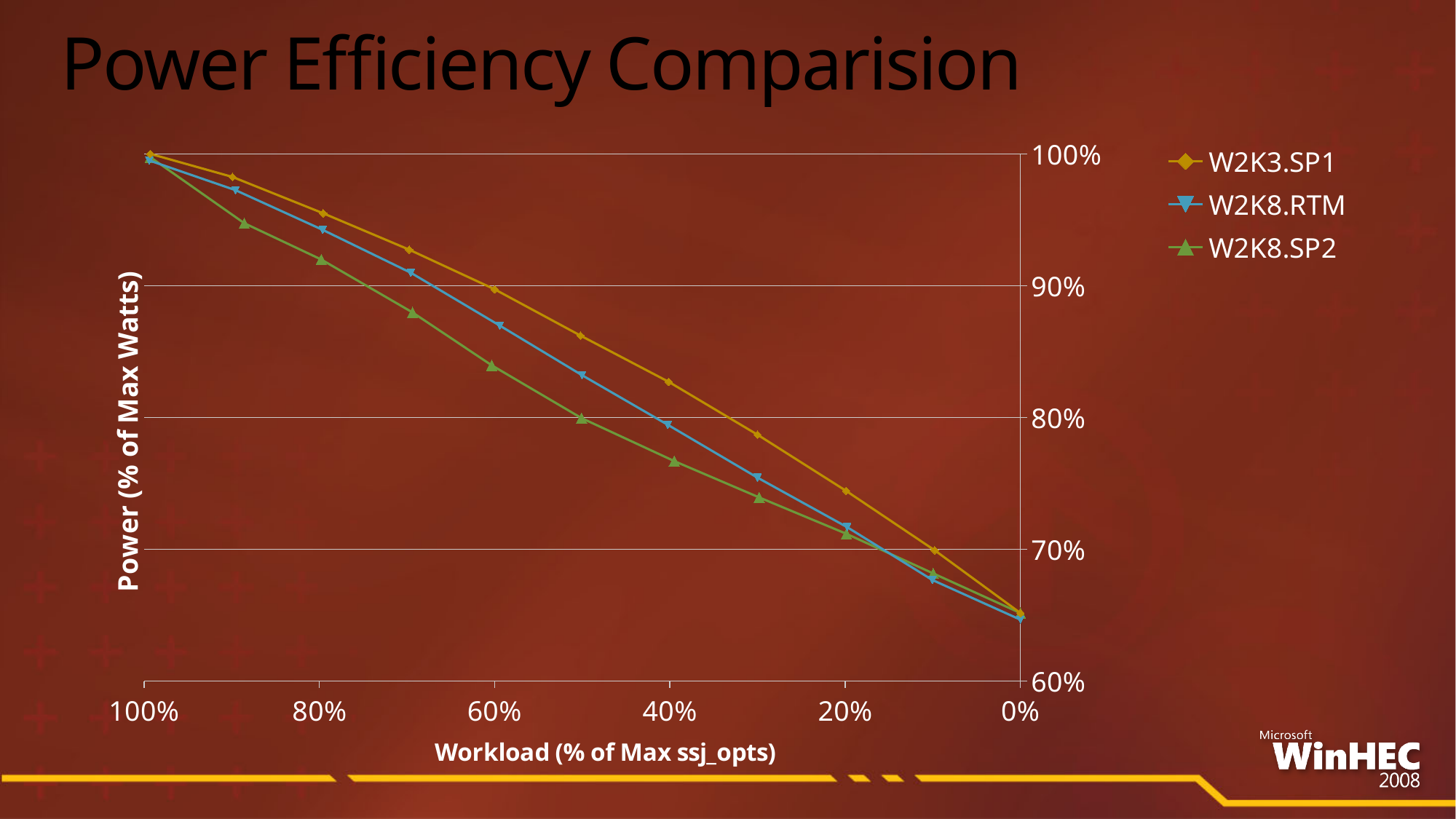
At 40% workload, which series has the larger power value, W2K3.SP1 or W2K8.SP2? W2K3.SP1 Do the power values rise or fall as the workload goes from 100% to 0% along the x axis? fall Is the value for W2K8.SP2 at 60% workload greater or less than 90%? less What kind of chart is shown on the slide? line chart What is the power value for W2K3.SP1 at 100% workload? 100% Is the value for W2K8.SP2 at 40% workload greater or less than 80%? less What is the title of the chart's y axis? Power (% of Max Watts) How many data points are plotted for the W2K8.SP2 series? 11 Which series has the lowest power value at 60% workload? W2K8.SP2 How many series does the legend list? 3 Which series are listed in the legend? W2K3.SP1, W2K8.RTM, W2K8.SP2 Is the value for W2K3.SP1 at 40% workload greater or less than 80%? greater